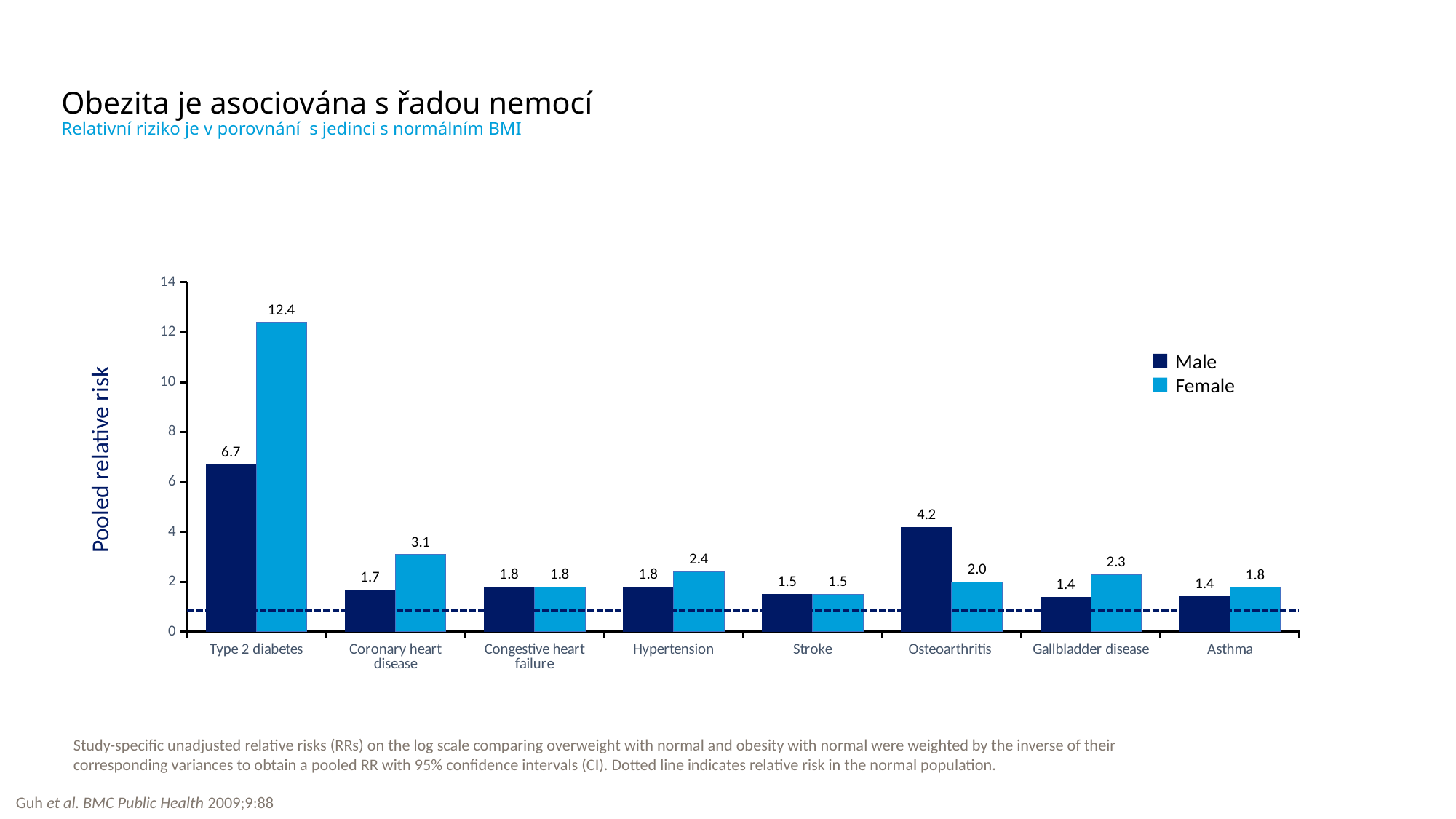
What is the label of the y axis? Pooled relative risk What kind of chart is shown on the slide? Bar chart Which category has the highest Female pooled relative risk? Type 2 diabetes What is the pooled relative risk for Female in the Gallbladder disease category? 2.3 How many series does the legend list? 2 What is the pooled relative risk for Male in the Osteoarthritis category? 4.2 Which is larger for Osteoarthritis, the Male or the Female pooled relative risk? Male What is the difference between the Female and Male pooled relative risk for Type 2 diabetes? 5.7 How many disease categories are shown on the x axis? 8 Is the Male value for Type 2 diabetes greater or less than 6? greater Which category has the lowest Female pooled relative risk? Stroke What is the pooled relative risk for Female in the Type 2 diabetes category? 12.4